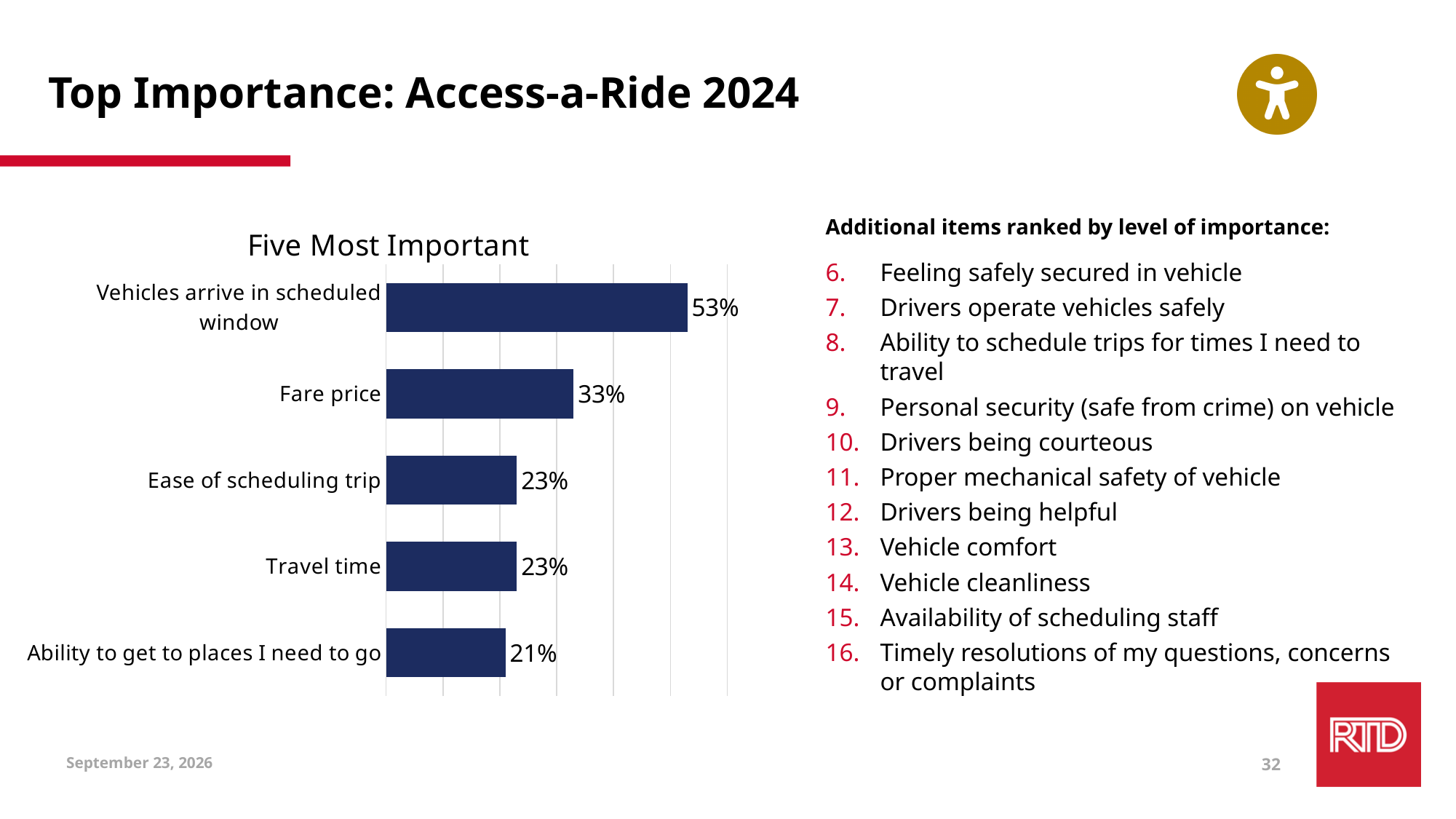
How many categories are shown in the bar chart? 5 What is the difference between the values for "Vehicles arrive in scheduled window" and "Fare price"? 20% What kind of chart is shown on the slide? Bar chart What is the value for "Fare price"? 33% Which is larger, the value for "Fare price" or the value for "Ease of scheduling trip"? Fare price What percentage is shown for "Vehicles arrive in scheduled window"? 53% Which category has the highest value in the chart? Vehicles arrive in scheduled window Which two categories share the same value of 23%? Ease of scheduling trip and Travel time What percentage is shown for "Ability to get to places I need to go"? 21% What is the title of the chart? Five Most Important What is the difference between the values for "Fare price" and "Travel time"? 10% Which category has the lowest value in the chart? Ability to get to places I need to go